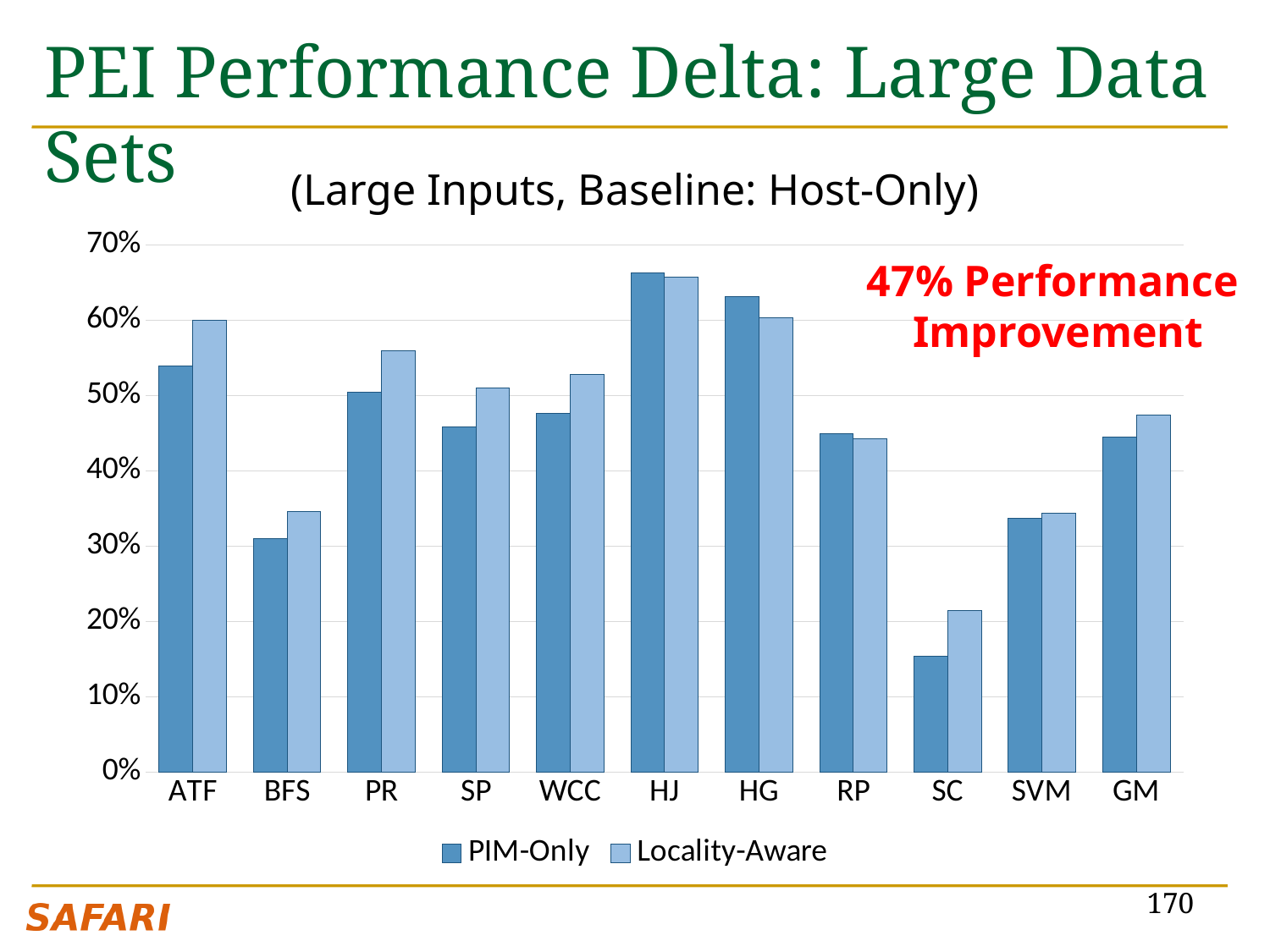
Which category has the lowest PIM-Only value? SC Is the Locality-Aware value for BFS greater or less than 30%? greater For ATF, which is larger: the PIM-Only value or the Locality-Aware value? Locality-Aware For HG, which is larger: the PIM-Only value or the Locality-Aware value? PIM-Only How many categories are shown on the x axis? 11 Which category has the highest PIM-Only value? HJ What is the subtitle shown above the chart? (Large Inputs, Baseline: Host-Only) How many series does the legend list? 2 What kind of chart is shown on the slide? bar chart Which category has the lowest Locality-Aware value? SC Is the PIM-Only value for ATF greater or less than 50%? greater Is the PIM-Only value for SC greater or less than 20%? less